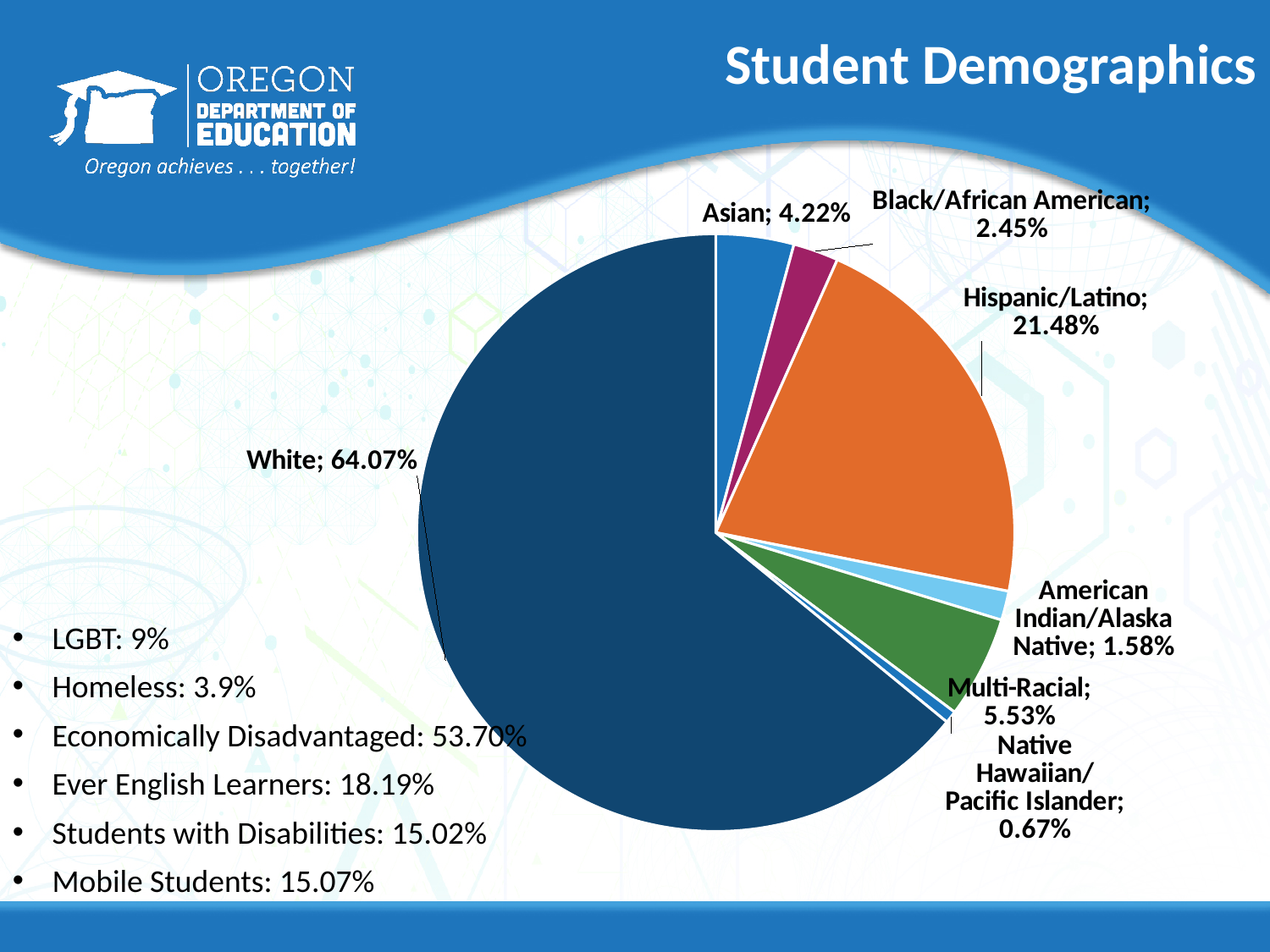
Which group has the largest slice of the pie? White What share of students is Asian? 4.22% What share of students is Hispanic/Latino? 21.48% Which group has the smallest slice of the pie? Native Hawaiian/Pacific Islander What is the difference between the Multi-Racial share and the Asian share? 1.31% What share of students is Multi-Racial? 5.53% What share of students is Native Hawaiian/Pacific Islander? 0.67% What kind of chart is shown on the slide? pie chart What is the difference between the White share and the Hispanic/Latino share? 42.59% What share of students is White? 64.07% Which is larger, the Black/African American share or the American Indian/Alaska Native share? Black/African American How many slices does the pie chart have? 7